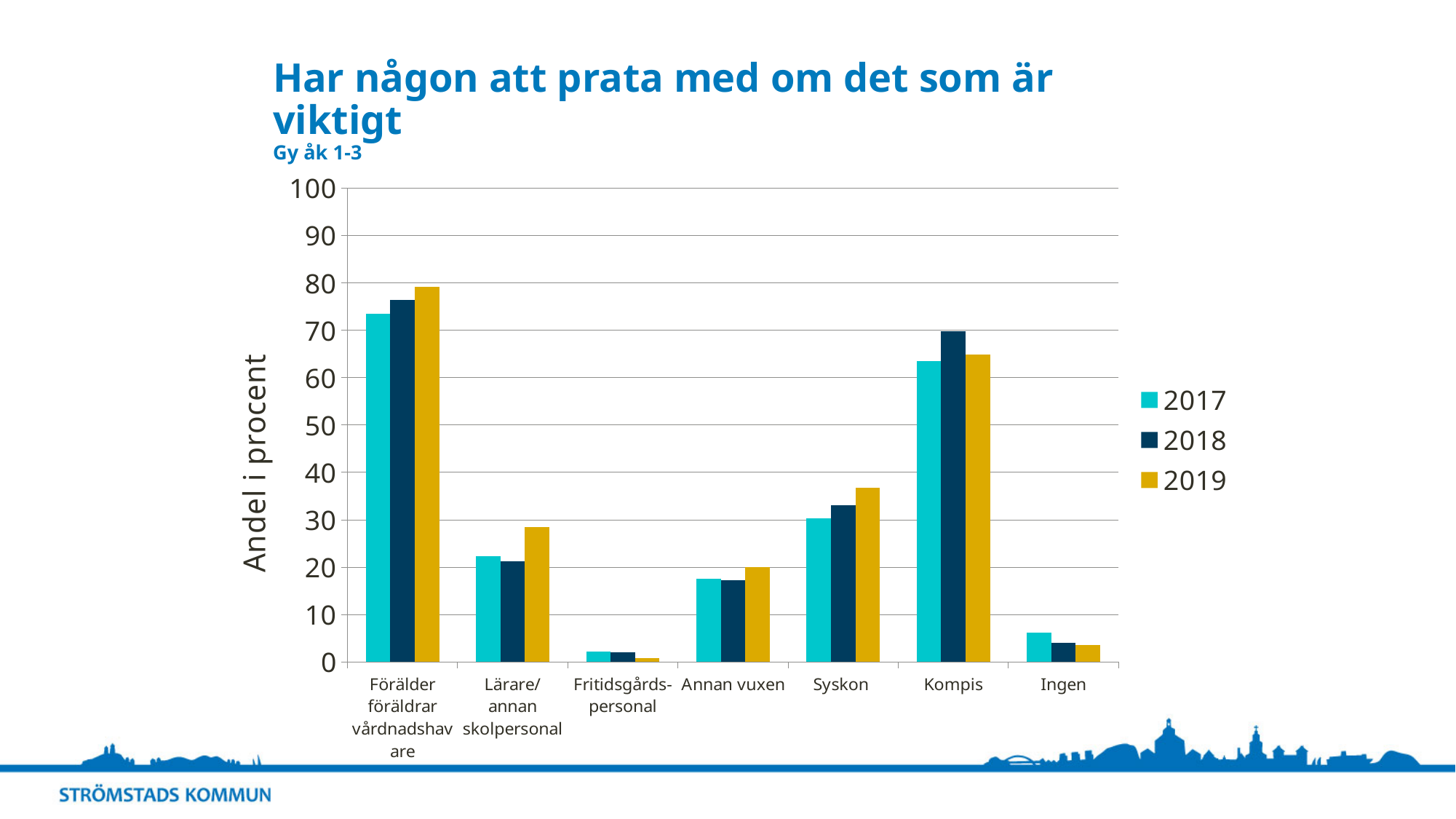
Which category has the lowest value for 2018? Fritidsgårdspersonal What kind of chart is shown on the slide? bar chart For Kompis, which year has the larger value, 2017 or 2018? 2018 Is the 2019 value for Förälder/föräldrar/vårdnadshavare greater or less than 70? greater Is the 2017 value for Ingen greater or less than 10? less Is the 2017 value for Syskon greater or less than 40? less How many categories are shown along the x axis? 7 Which category has the highest value for 2019? Förälder/föräldrar/vårdnadshavare For 2019, which category has the larger value, Syskon or Lärare/annan skolpersonal? Syskon What is the title of the y axis? Andel i procent How many series does the legend list? 3 Do the values for Syskon rise or fall from 2017 to 2019? rise